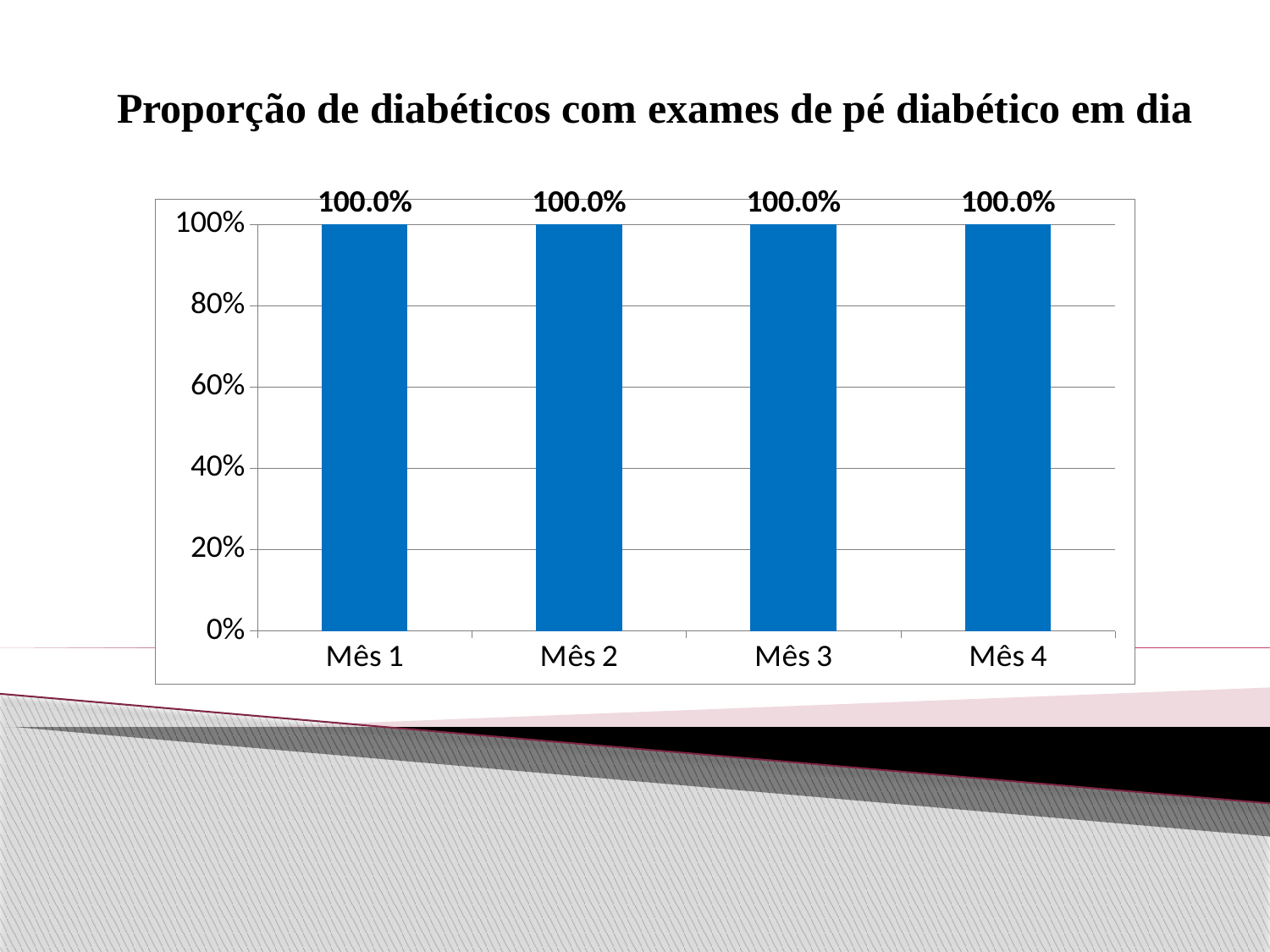
What is the difference between the values for Mês 2 and Mês 4? 0.0% Do the values rise, fall, or stay the same from Mês 1 to Mês 4? stay the same How many categories are shown on the x axis? 4 What is the value for Mês 1? 100.0% What is the value for Mês 4? 100.0% What kind of chart is shown on the slide? bar chart What colour are the bars in the chart? blue What is the title of the slide? Proporção de diabéticos com exames de pé diabético em dia What is the value for Mês 3? 100.0% Is the value for Mês 2 greater or less than 80%? greater